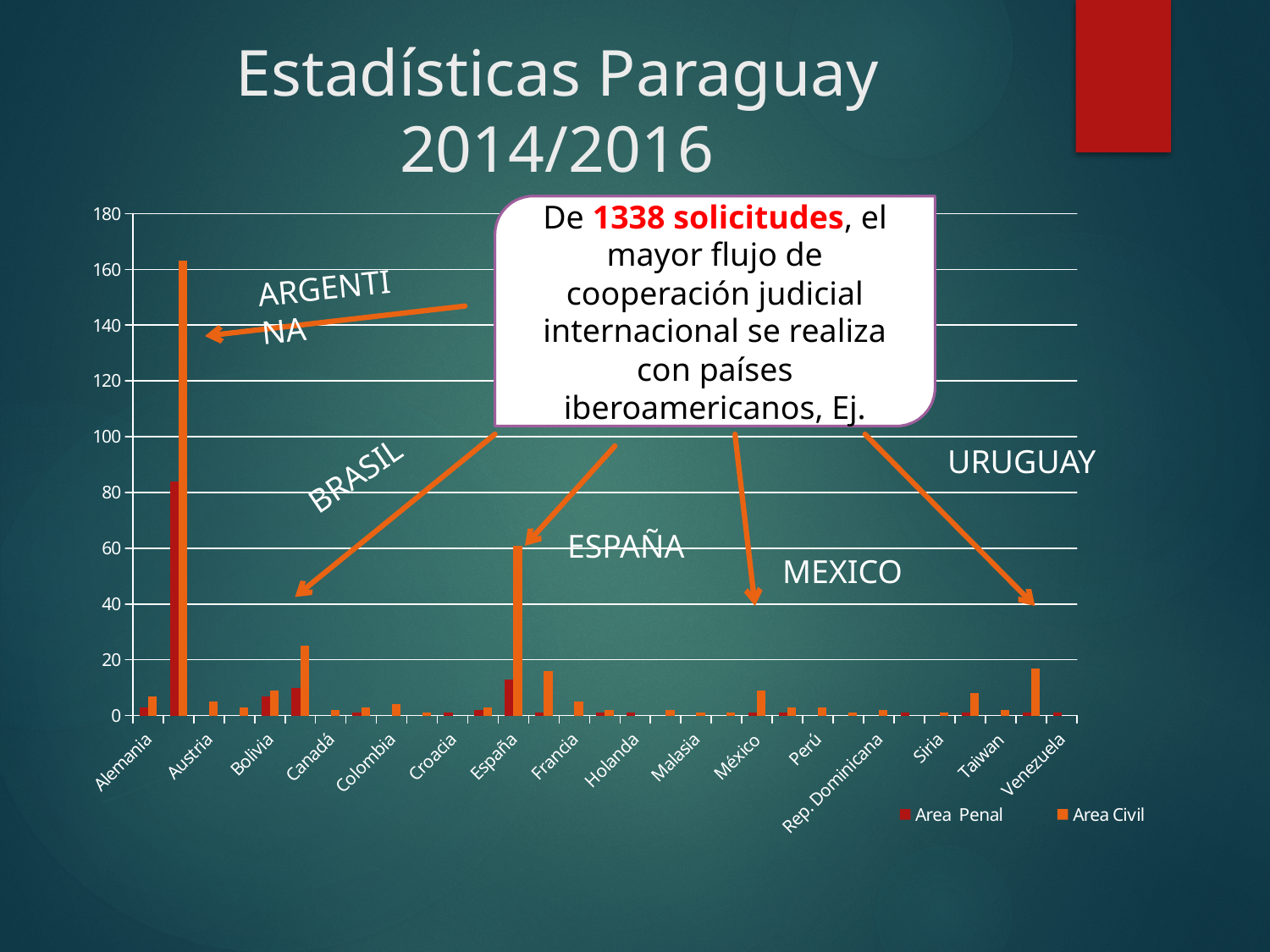
Which has the larger Area Civil value, España or Francia? España Which series contains the tallest bar in the chart? Area Civil Is the Area Civil value for Alemania greater or less than 20? less Is the Area Civil value for España greater or less than 80? less What are the two series named in the chart legend? Area Penal and Area Civil What kind of chart is shown on the slide? bar chart Is the Area Civil value for Francia greater or less than 20? less How many series does the chart legend list? 2 For España, which series has the larger value, Area Penal or Area Civil? Area Civil What is the title of the slide containing the chart? Estadísticas Paraguay 2014/2016